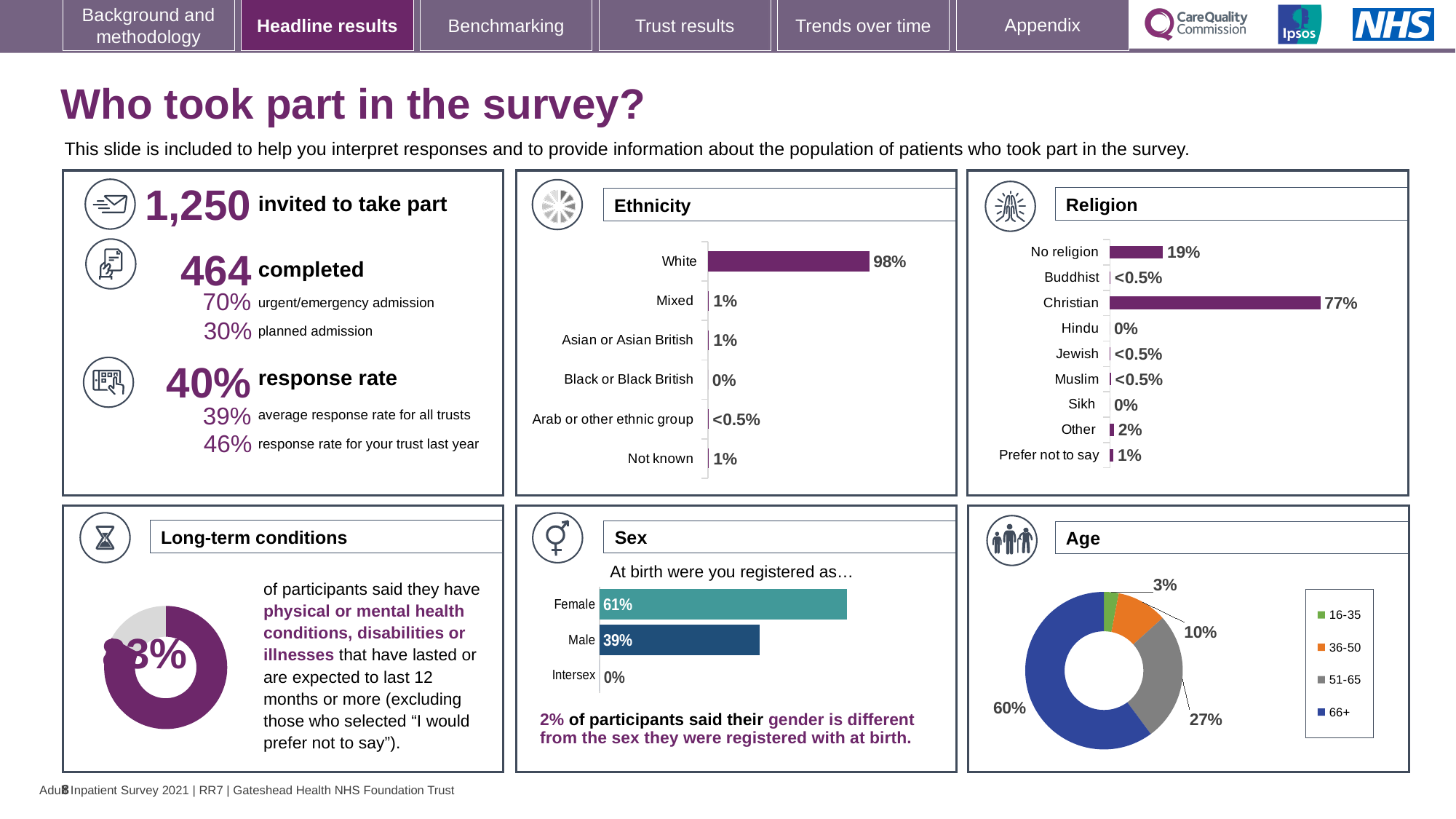
In the Sex chart, what percentage of participants were registered as Female at birth? 61% In the Religion chart, which is larger, Other or Prefer not to say? Other How many religion categories are listed in the Religion chart? 9 In the Religion chart, what percentage of participants were Christian? 77% In the Religion chart, what is the difference between the Christian and No religion percentages? 58% How many ethnic group categories are shown in the Ethnicity chart? 6 What type of chart is used for the Age breakdown? Donut chart In the Ethnicity chart, what is the value for Arab or other ethnic group? <0.5% In the Ethnicity chart, which ethnic group has the highest percentage? White In the Ethnicity chart, what percentage of participants were White? 98% In the Sex chart, what is the difference between the Female and Male percentages? 22% In the Age chart, what share of participants were aged 66+? 60%